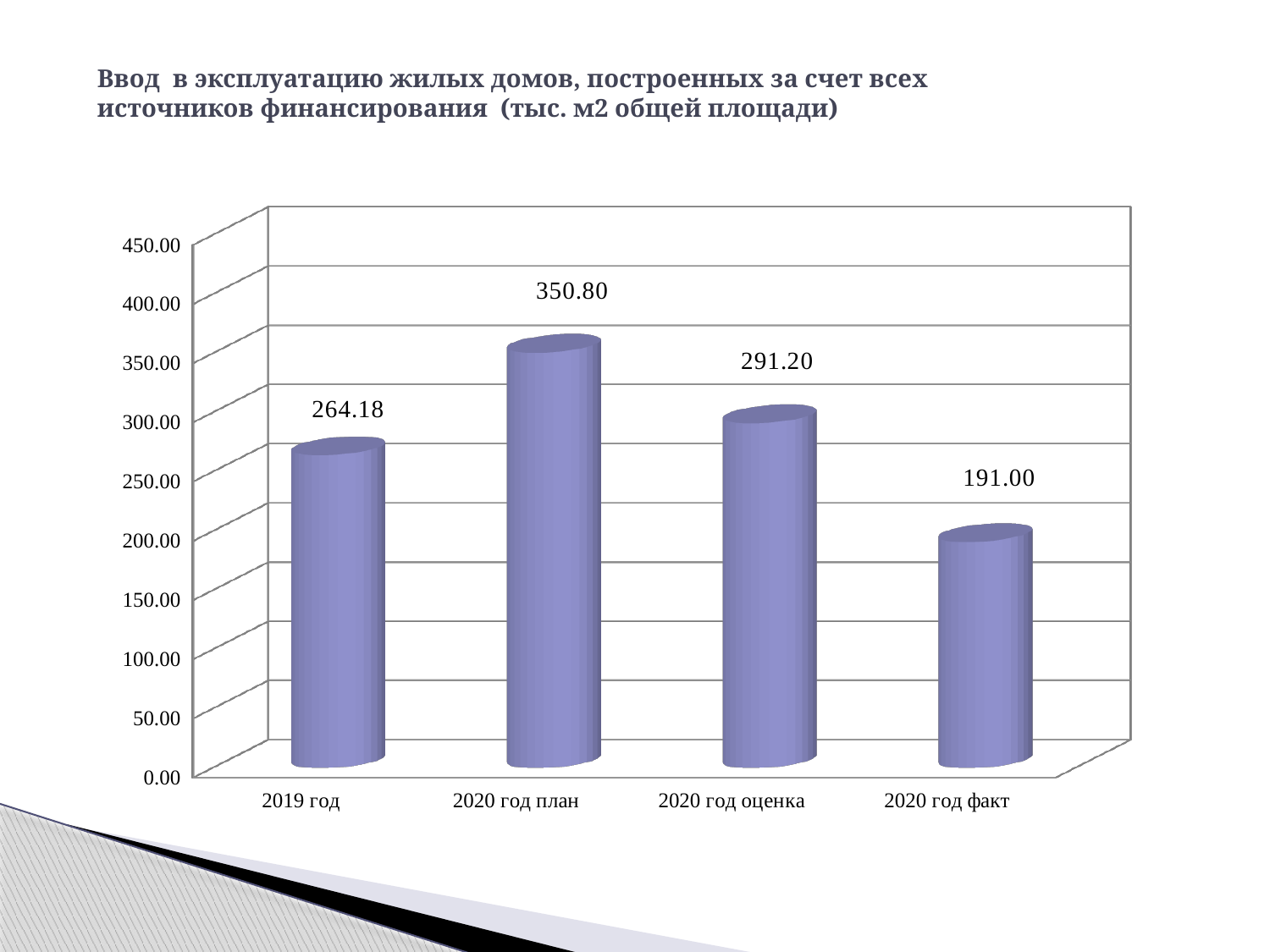
Is the value for 2020 год факт greater or less than 200.00? less What is the value for 2020 год план? 350.80 What is the value for 2019 год? 264.18 Which is larger, the value for 2019 год or the value for 2020 год оценка? 2020 год оценка What is the value for 2020 год оценка? 291.20 What kind of chart is shown on the slide? bar chart What is the difference between the values for 2020 год план and 2020 год факт? 159.80 How many categories are shown on the x axis? 4 What is the value for 2020 год факт? 191.00 Which category has the highest value? 2020 год план What is the difference between the values for 2020 год оценка and 2019 год? 27.02 Which category has the lowest value? 2020 год факт